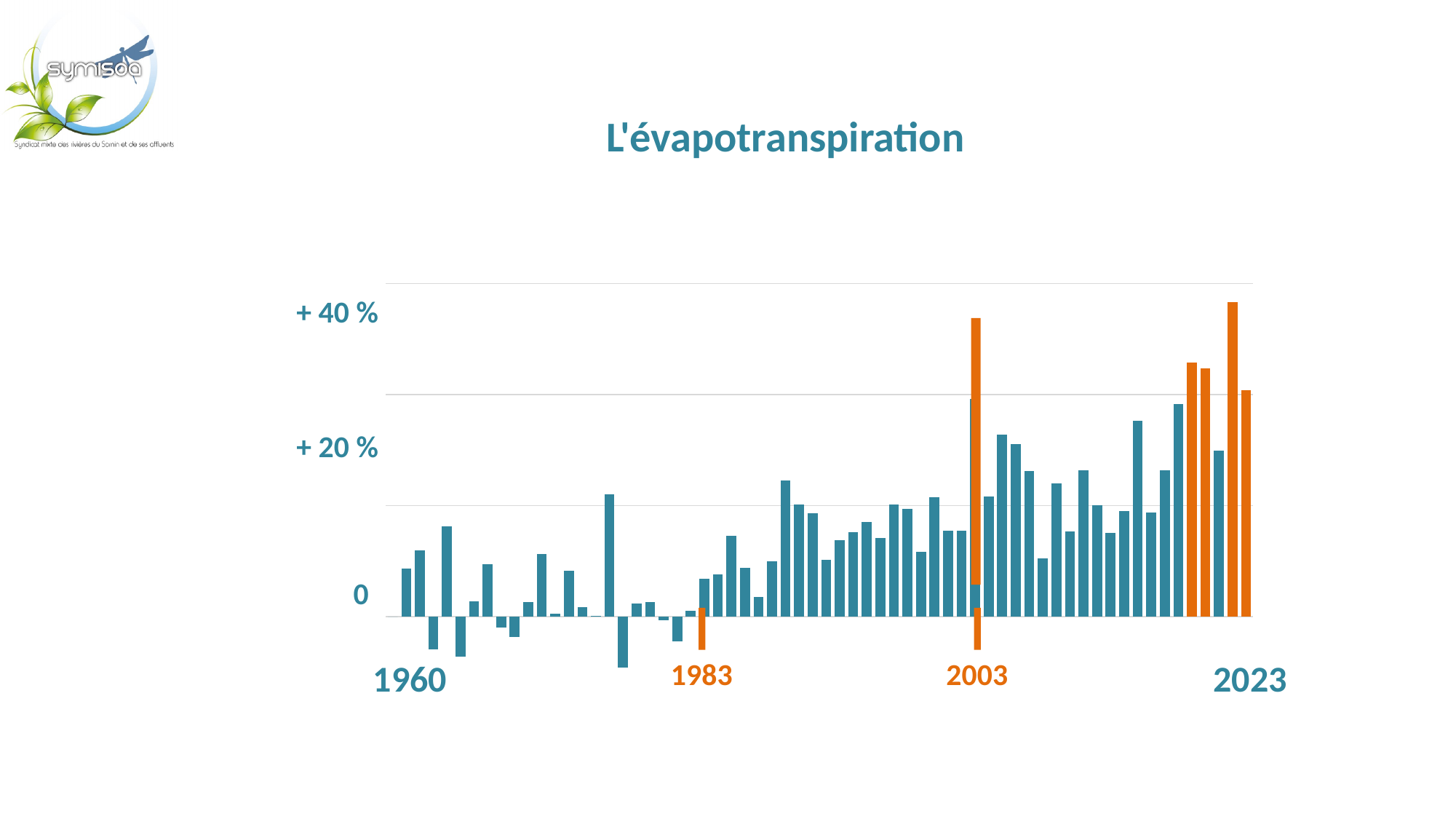
What is the title of the chart? L'évapotranspiration Is the value for 2023 greater or less than 20 %? greater Do the values generally rise or fall from 1960 to 2023? rise Which year has the larger value, 1983 or 2003? 2003 Is the value for 1983 greater or less than 0? greater What is the first year labelled on the x axis? 1960 What kind of chart is shown on the slide? bar chart Is the value for 2003 greater or less than 20 %? greater